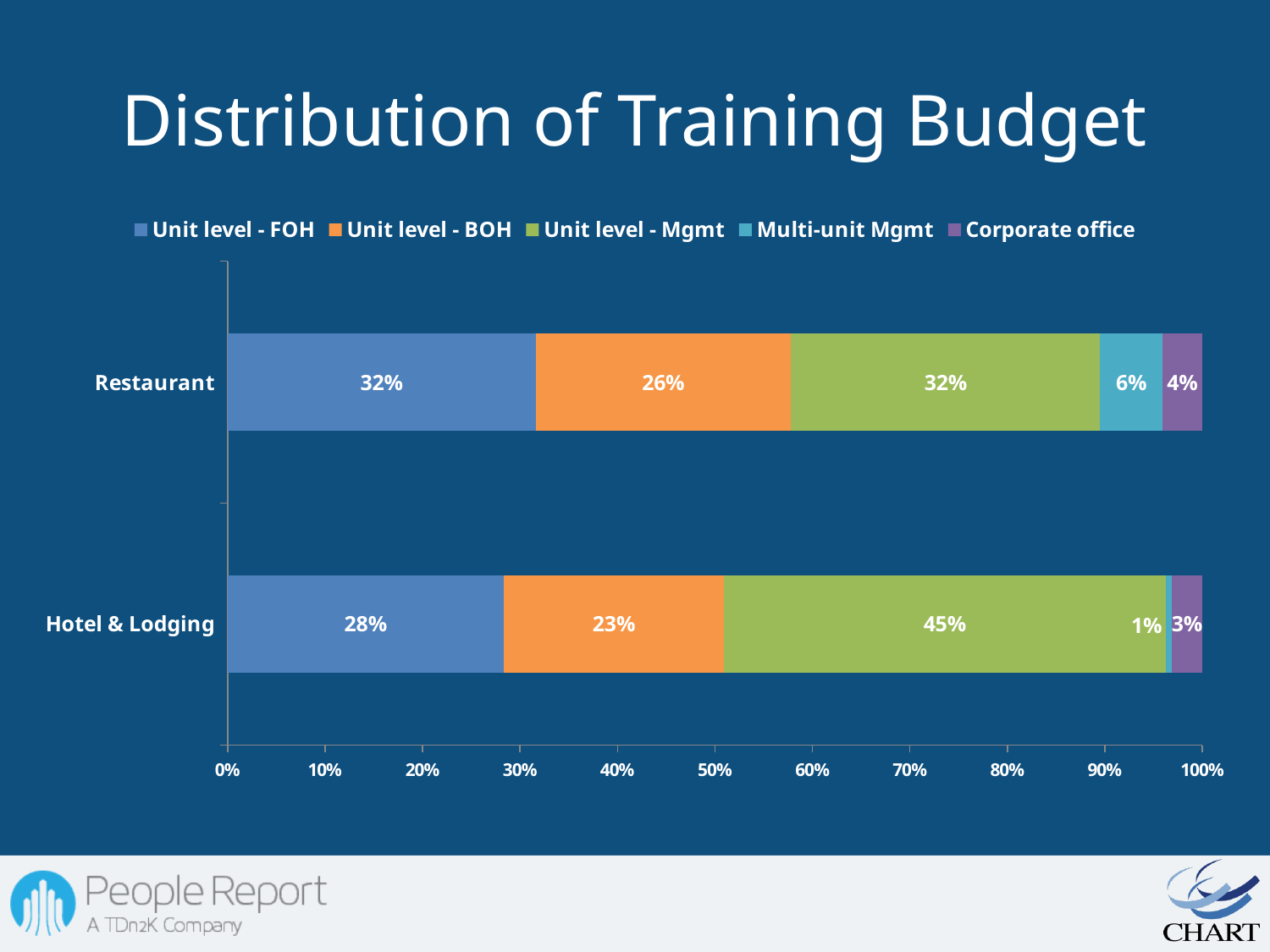
What is the difference between the Unit level - Mgmt values for Hotel & Lodging and Restaurant? 13% What kind of chart is shown on the slide? Stacked bar chart What is the Corporate office value for Hotel & Lodging? 3% What is the Multi-unit Mgmt value for Restaurant? 6% What is the difference between the Multi-unit Mgmt values for Restaurant and Hotel & Lodging? 5% What is the Unit level - Mgmt value for Hotel & Lodging? 45% Which category has the higher Unit level - BOH value, Restaurant or Hotel & Lodging? Restaurant How many categories are shown on the chart? 2 Which series has the smallest value in the Hotel & Lodging bar? Multi-unit Mgmt How many series does the legend list? 5 What is the Unit level - FOH value for Restaurant? 32% Which series has the largest value in the Hotel & Lodging bar? Unit level - Mgmt